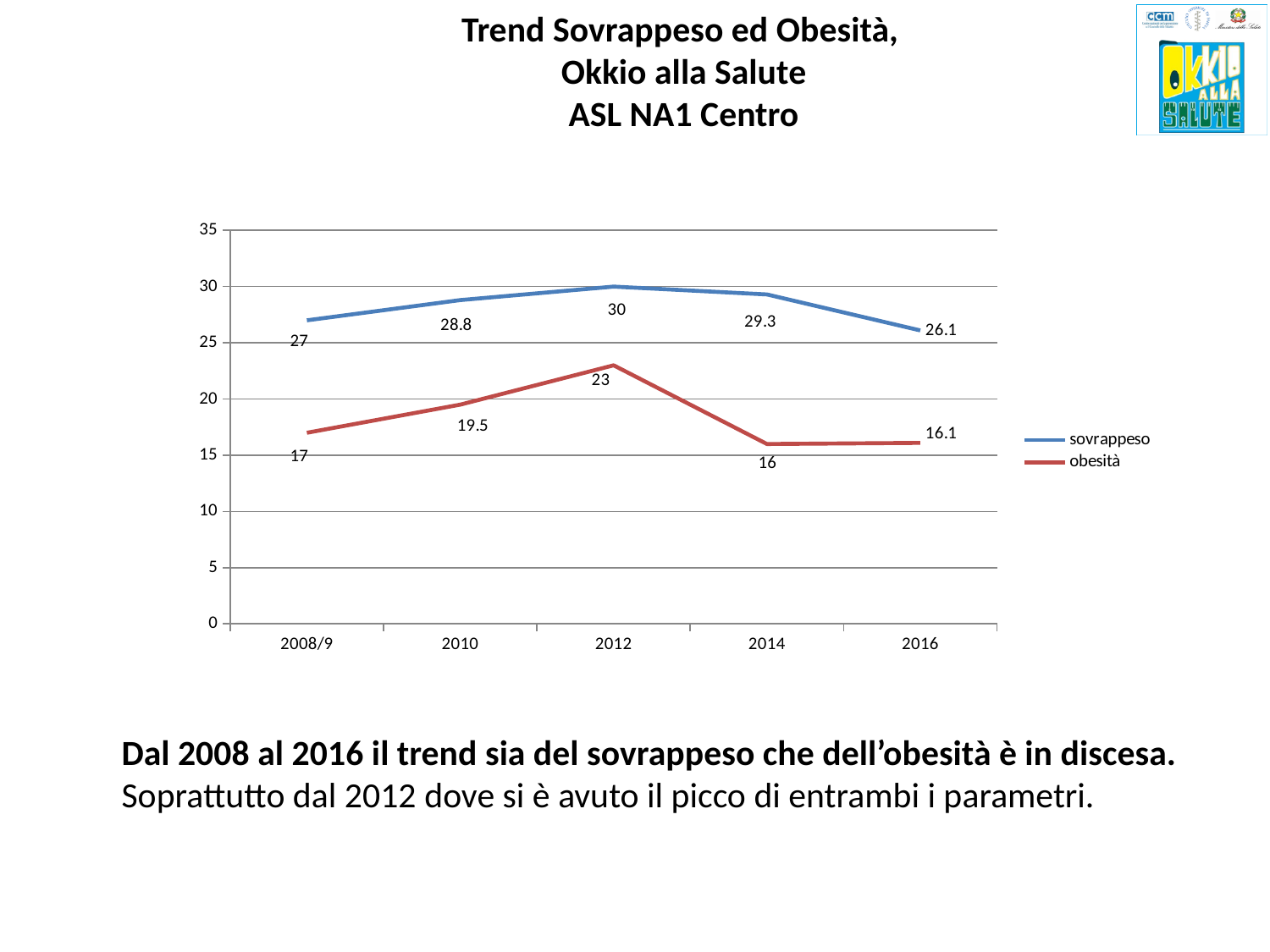
Which is larger, obesità in 2008/9 or obesità in 2014? 2008/9 How many series does the legend list? 2 What is the value of obesità in 2016? 16.1 In which year is obesità highest? 2012 What is the value of obesità in 2010? 19.5 Does obesità rise or fall from 2012 to 2014? fall What kind of chart is shown on the slide? line chart How many years are shown on the x axis? 5 In which year is sovrappeso lowest? 2016 What is the difference between sovrappeso and obesità in 2014? 13.3 What is the value of sovrappeso in 2012? 30 Which colour is used for the sovrappeso line? blue